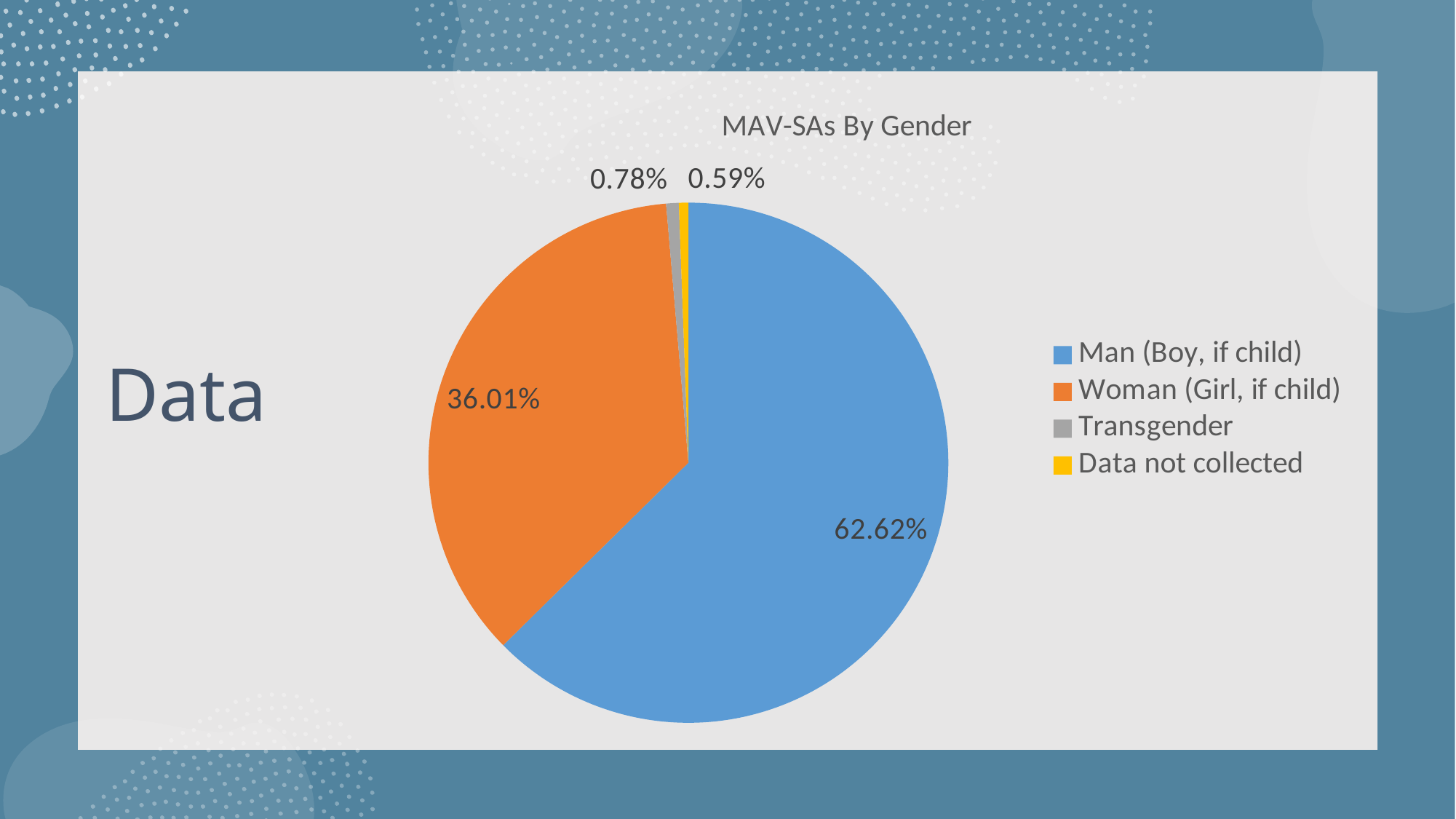
What percentage of MAV-SAs are Man (Boy, if child)? 62.62% What percentage of MAV-SAs are Transgender? 0.78% What colour represents Woman (Girl, if child) in the chart? orange What is the difference in percentage points between Man (Boy, if child) and Woman (Girl, if child)? 26.61 How many categories does the legend list? 4 Which category has the largest share of the pie? Man (Boy, if child) What percentage of MAV-SAs are Woman (Girl, if child)? 36.01% What percentage of MAV-SAs fall under Data not collected? 0.59% Which category has the smallest share of the pie? Data not collected Which is larger, the share for Transgender or the share for Data not collected? Transgender What is the title of the chart? MAV-SAs By Gender What kind of chart is shown on the slide? pie chart